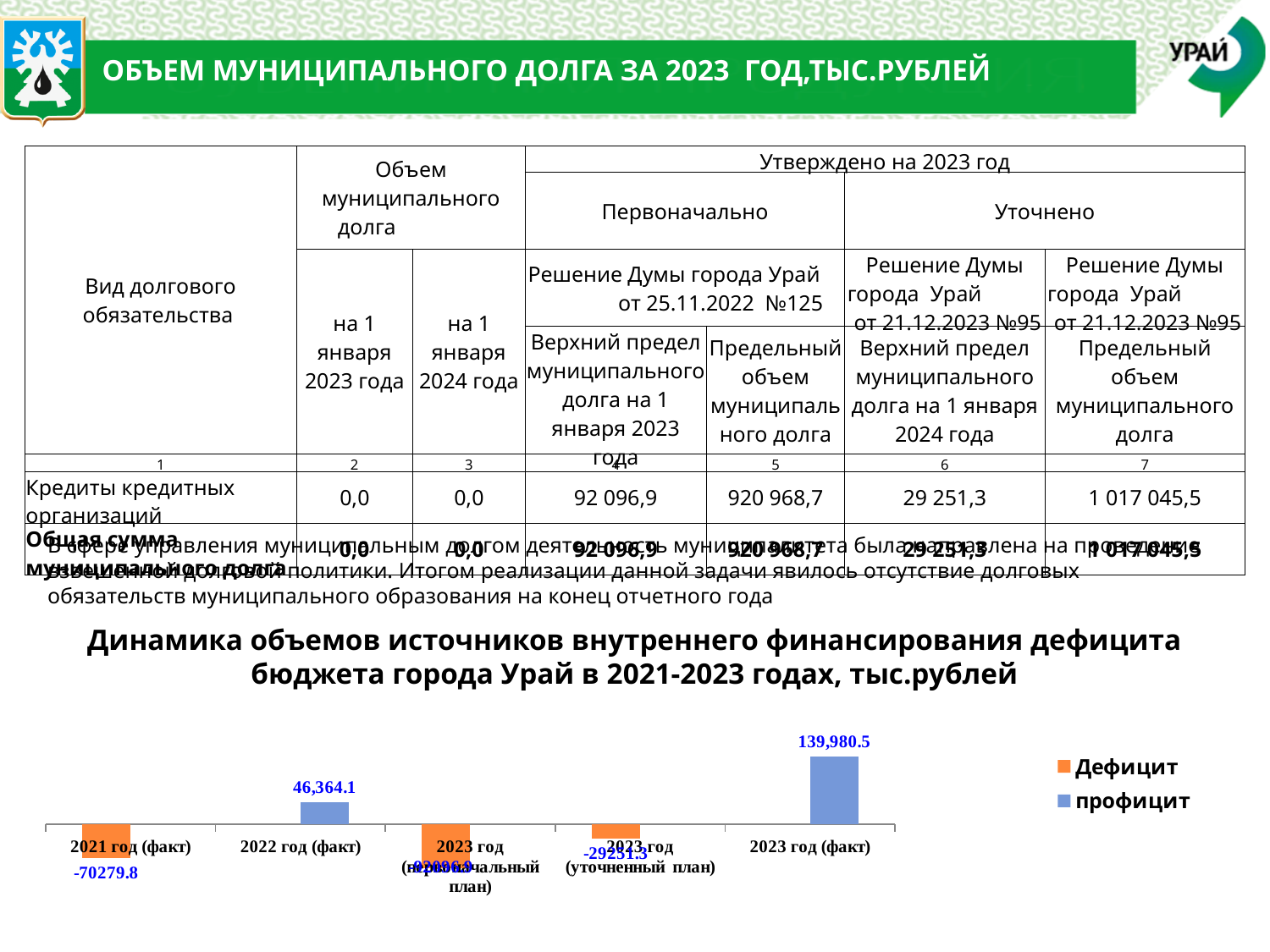
In the chart, what is the value for 2021 год (факт)? -70279.8 Which category in the chart has the highest value? 2023 год (факт) In the chart, what is the value for 2023 год (факт)? 139,980.5 What are the two legend entries of the chart? Дефицит, профицит How many categories are shown on the x axis of the chart? 5 Which is larger in the chart: the value for 2022 год (факт) or the value for 2023 год (факт)? 2023 год (факт) What is the difference between the values for 2023 год (факт) and 2022 год (факт) in the chart? 93,616.4 How many series does the chart legend list? 2 In the chart, what is the value for 2023 год (уточненный план)? -29251.3 What colour are the Дефицит bars in the chart? orange What type of chart is shown at the bottom of the slide? bar chart In the chart, what is the value for 2022 год (факт)? 46,364.1